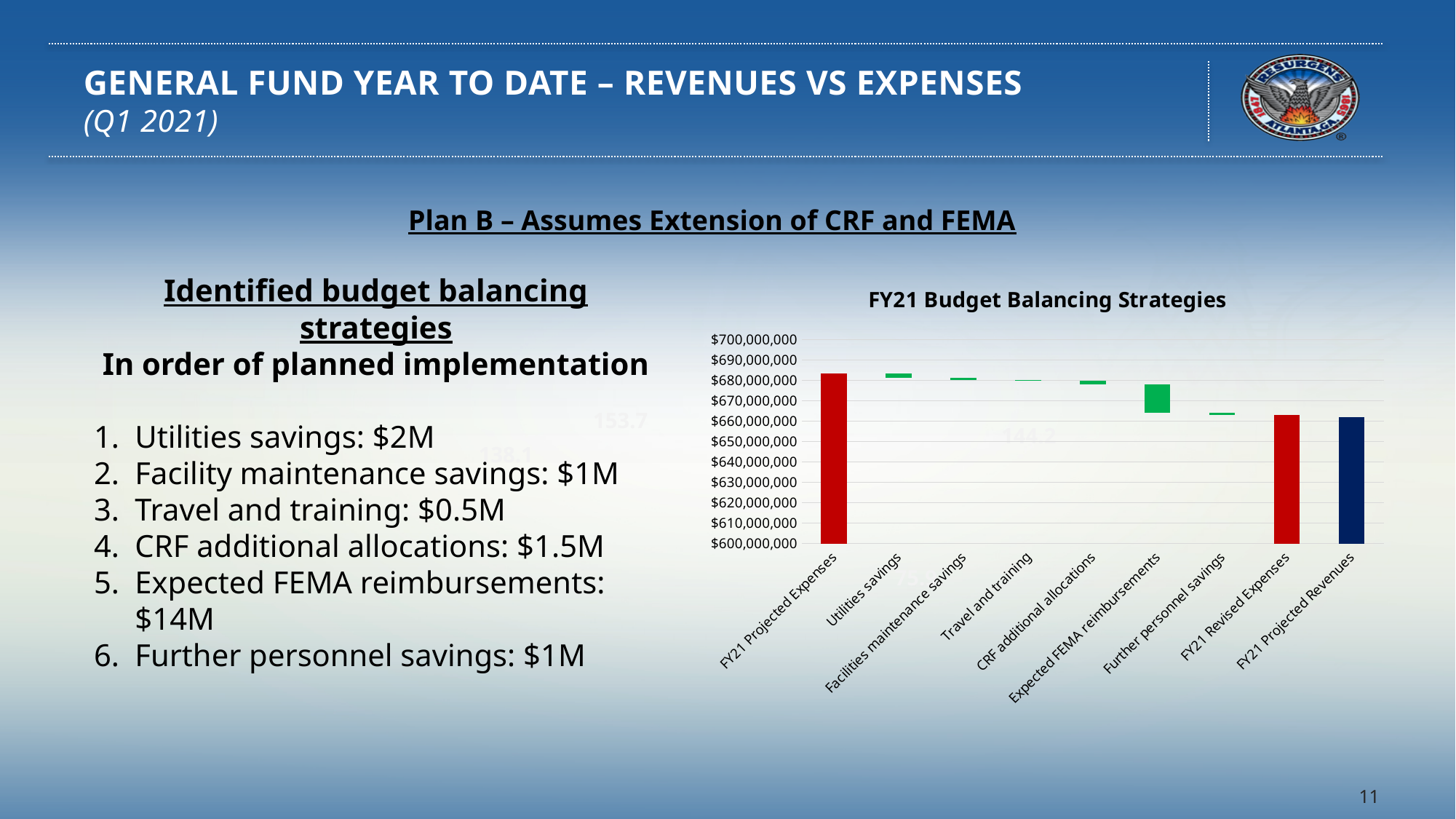
Is the value for FY21 Projected Revenues greater or less than $670,000,000? less Which category has the tallest bar in the FY21 Budget Balancing Strategies chart? FY21 Projected Expenses Is the value for FY21 Projected Expenses greater or less than $670,000,000? greater What colour is the FY21 Projected Revenues bar in the chart? dark blue Which is larger, FY21 Projected Expenses or FY21 Revised Expenses? FY21 Projected Expenses How many categories are shown on the x axis of the FY21 Budget Balancing Strategies chart? 9 What kind of chart is the FY21 Budget Balancing Strategies chart? bar chart Do the expense levels rise or fall from FY21 Projected Expenses to FY21 Revised Expenses across the chart? fall Which of the green savings segments in the FY21 Budget Balancing Strategies chart is the largest? Expected FEMA reimbursements Is the value for FY21 Revised Expenses greater or less than $650,000,000? greater What is the title of the chart on the slide? FY21 Budget Balancing Strategies What is the lowest value shown on the y axis of the FY21 Budget Balancing Strategies chart? $600,000,000